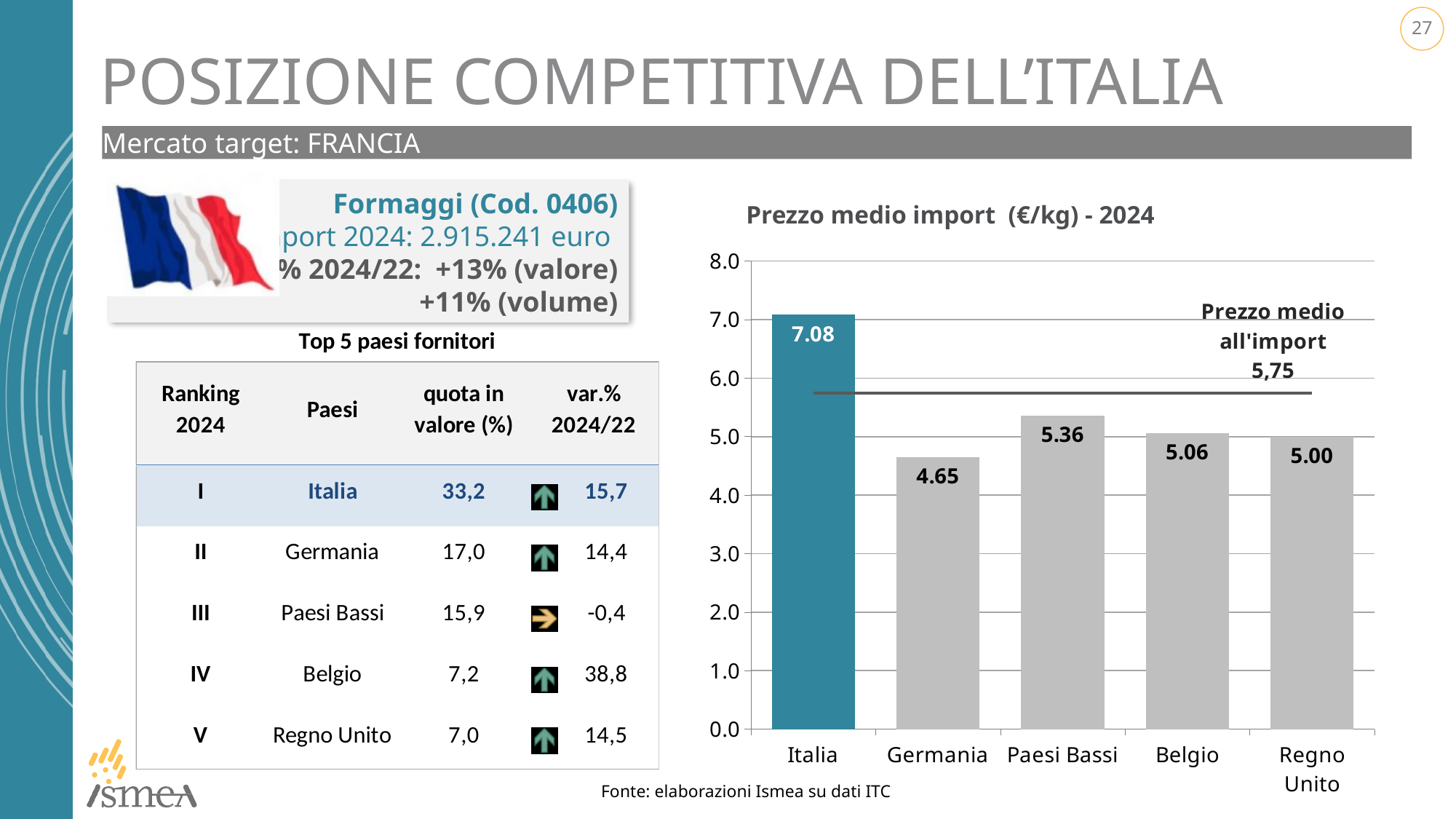
What is the average import price for Italia in the chart 'Prezzo medio import (€/kg) - 2024'? 7.08 What is the average import price for Paesi Bassi in the chart? 5.36 Which country has the highest average import price in the chart? Italia What kind of chart is used to show the average import price? Bar chart How many countries are shown in the bar chart? 5 Which has a higher average import price, Paesi Bassi or Belgio? Paesi Bassi What is the average import price for Germania in the chart? 4.65 Which country has the lowest average import price in the chart? Germania What is the title of the chart on the right of the slide? Prezzo medio import (€/kg) - 2024 What is the difference between the average import price for Italia and Germania? 2.43 What is the average import price for Regno Unito in the chart? 5.00 What is the value of the overall average import price ('Prezzo medio all'import') marked by the horizontal line in the chart? 5,75